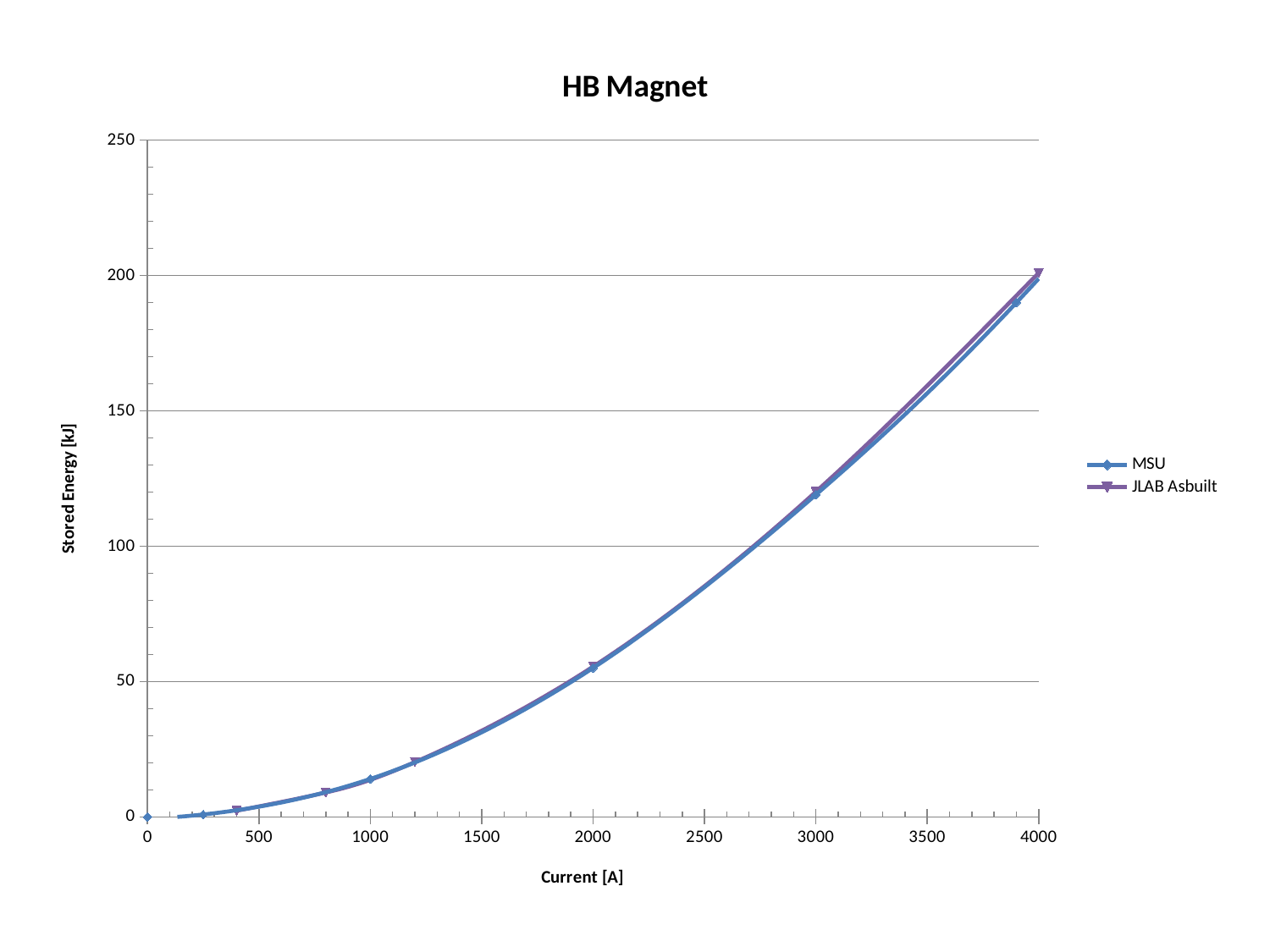
Is the JLAB Asbuilt value at 3000 A greater or less than 150? less Is the MSU value at 3000 A greater or less than 100? greater What kind of chart is shown on the slide? line chart How many series does the legend list? 2 Is the MSU value at 1000 A greater or less than 50? less Do the stored energy values rise or fall as current increases along the x axis? rise What is the title of the chart? HB Magnet What is the label of the y axis? Stored Energy [kJ]